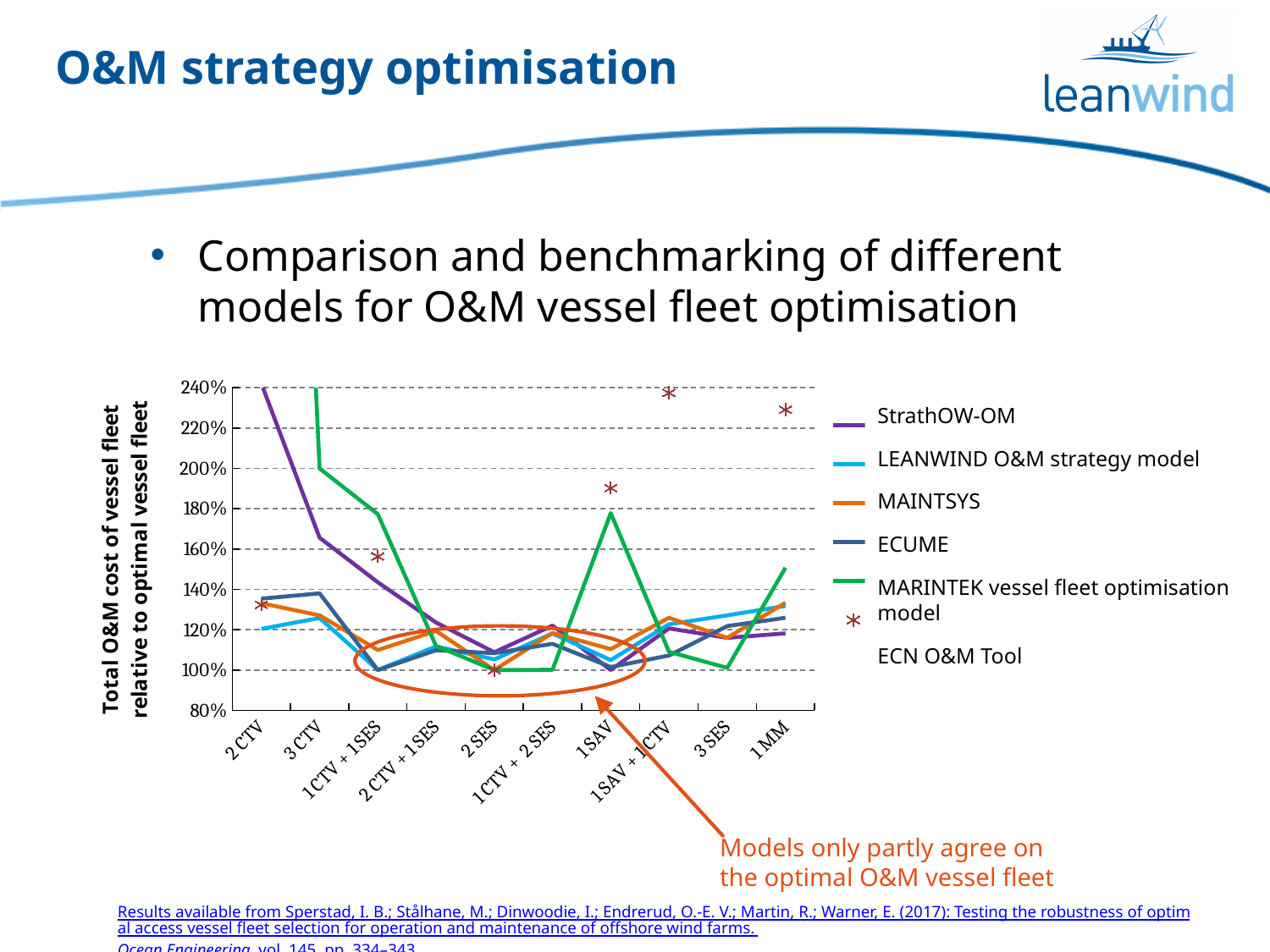
Is the value for StrathOW-OM at 3 CTV greater or less than 140%? greater Which series is plotted with asterisk markers instead of a line? ECN O&M Tool Is the value for the MARINTEK vessel fleet optimisation model at 3 SES greater or less than 120%? less How many vessel fleet categories are shown on the x axis? 10 What kind of chart is shown on the slide? line chart What is the title of the y axis? Total O&M cost of vessel fleet relative to optimal vessel fleet Is the value for the ECN O&M Tool at 1 MM greater or less than 200%? greater How many series does the legend list? 6